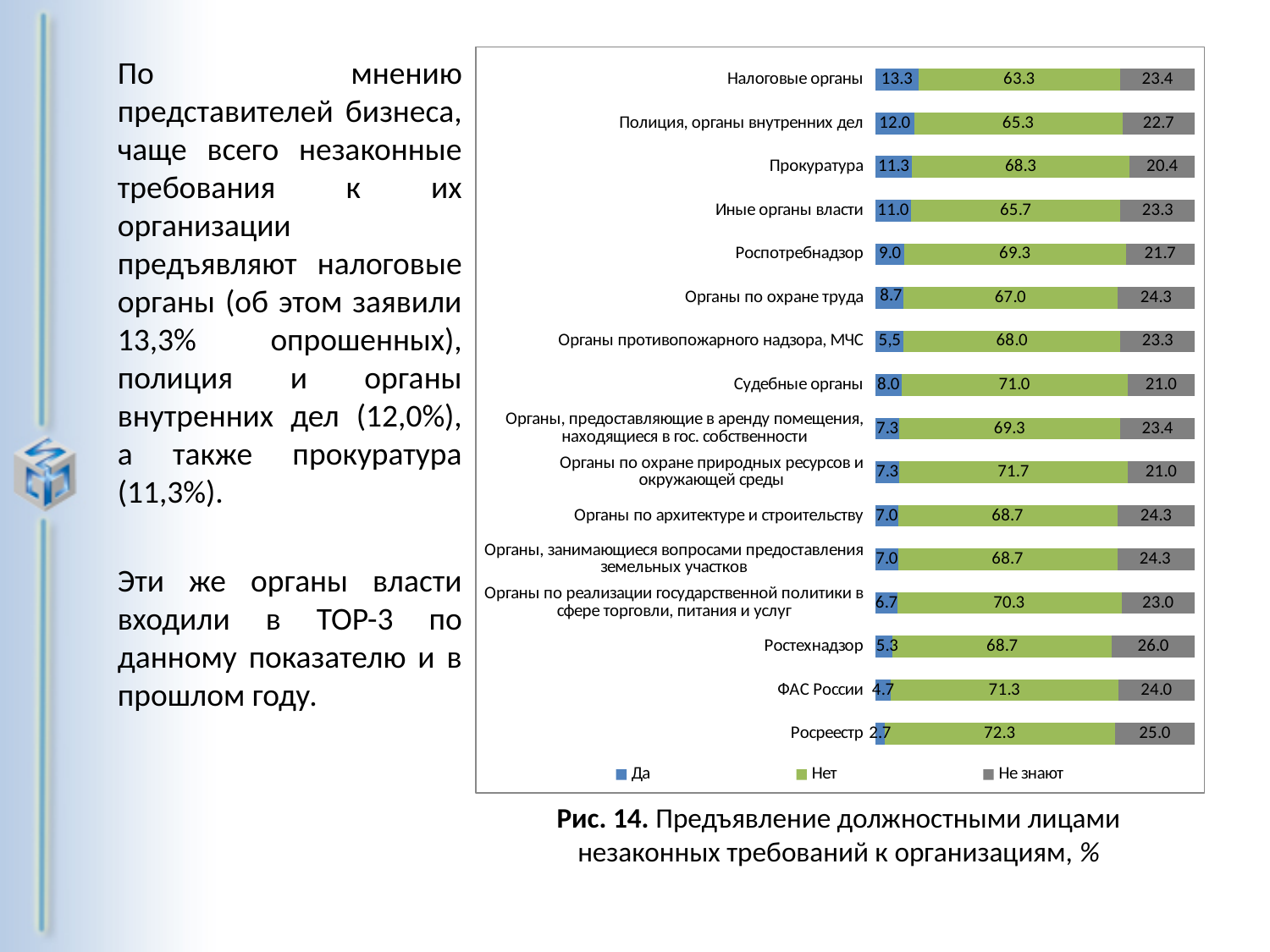
What is the 'Нет' value for Прокуратура? 68.3 How many categories (authorities) are shown in the chart? 16 Which category has the lowest 'Да' value? Росреестр Which category has the highest 'Да' value? Налоговые органы How many series does the legend list? 3 What is the 'Да' value for Налоговые органы? 13.3 What is the difference between the 'Да' values for Налоговые органы and Полиция, органы внутренних дел? 1.3 Which has a larger 'Да' value: Роспотребнадзор or Судебные органы? Роспотребнадзор Which category has the highest 'Нет' value? Росреестр What is the 'Не знают' value for Ростехнадзор? 26.0 What type of chart is shown on the slide? Stacked bar chart What is the total of the stacked bar for Прокуратура? 100.0